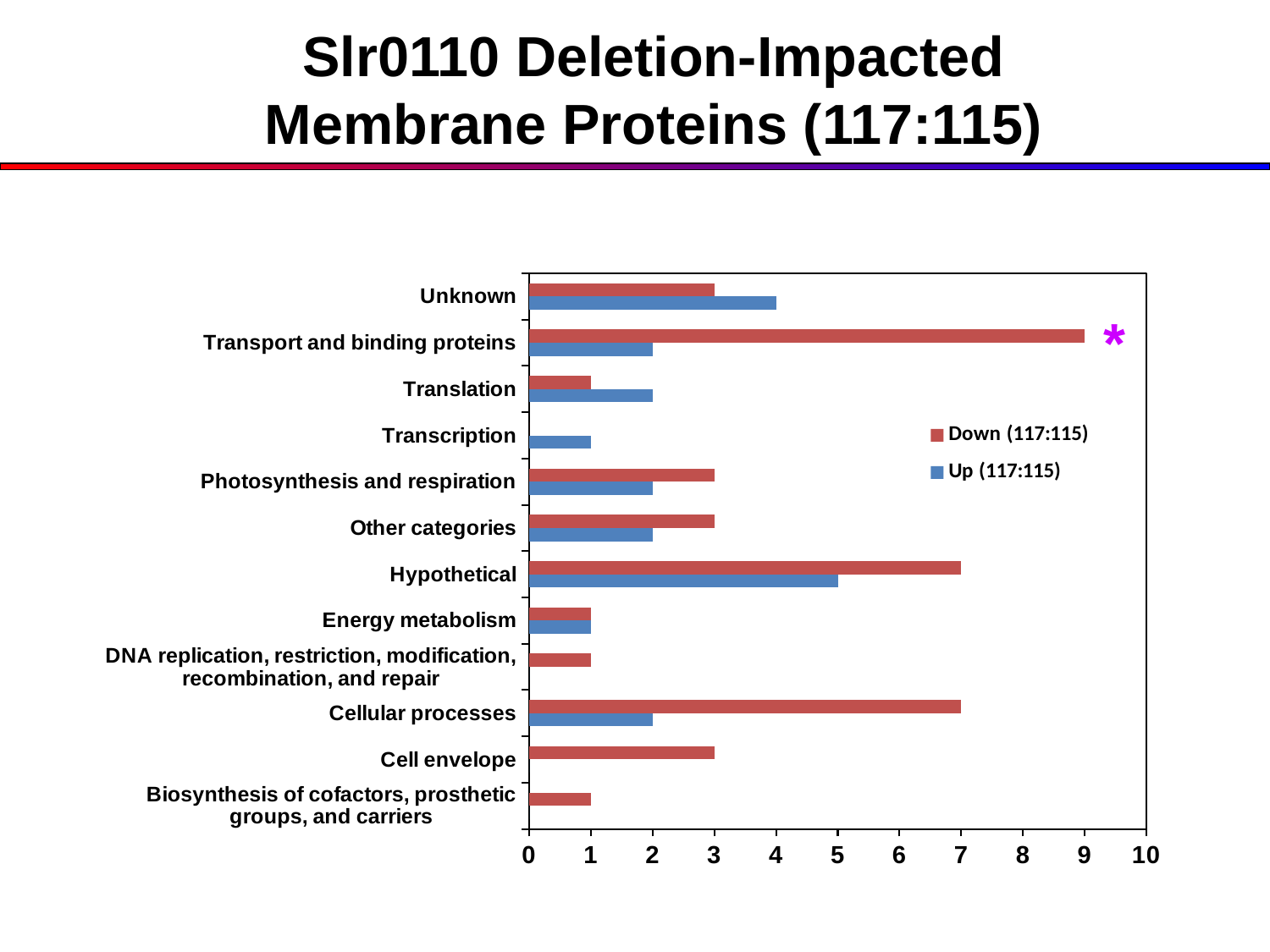
What kind of chart is shown on the slide? bar chart How many series does the legend list? 2 How many categories are shown on the chart? 12 What is the Up (117:115) value for Hypothetical? 5 Which category is marked with a magenta asterisk on the chart? Transport and binding proteins What is the Up (117:115) value for Unknown? 4 For Unknown, which is larger: the Down (117:115) value or the Up (117:115) value? Up (117:115) What is the Down (117:115) value for Transport and binding proteins? 9 What is the difference between the Down (117:115) and Up (117:115) values for Cellular processes? 5 Which category has the highest Up (117:115) value? Hypothetical Is the Down (117:115) value for Hypothetical greater or less than 5? greater Which category has the highest Down (117:115) value? Transport and binding proteins